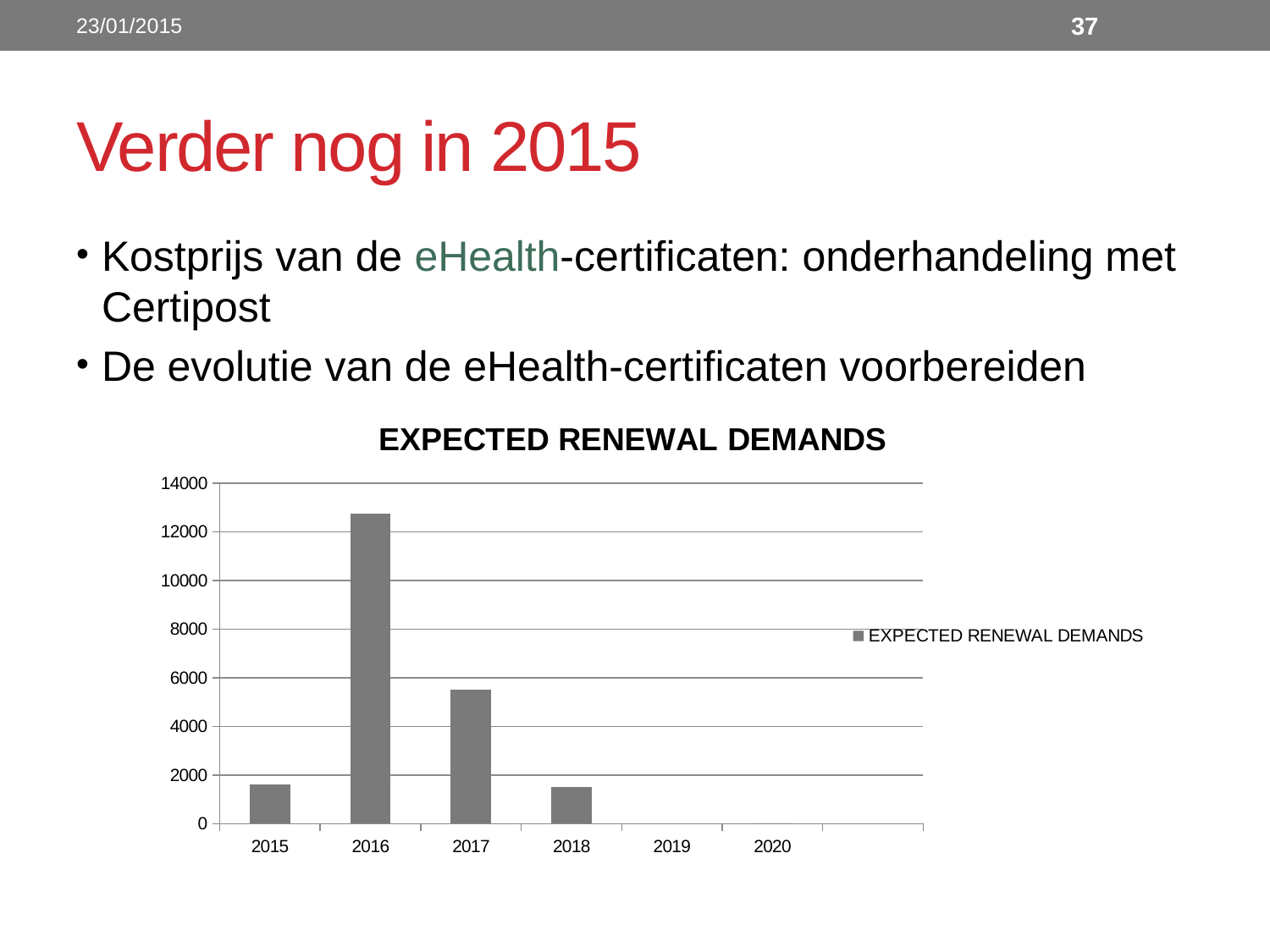
What kind of chart is shown on the slide? bar chart Is the value for 2015 greater or less than 2000? less Is the value for 2016 greater or less than 12000? greater How many years are shown on the x axis of the chart? 6 What is the title of the chart? EXPECTED RENEWAL DEMANDS Which is larger, the value for 2016 or the value for 2017? 2016 Is the value for 2017 greater or less than 6000? less Which year has the highest expected renewal demands? 2016 Do the values rise or fall from 2016 to 2018? fall Which is larger, the value for 2017 or the value for 2018? 2017 How many series does the chart legend list? 1